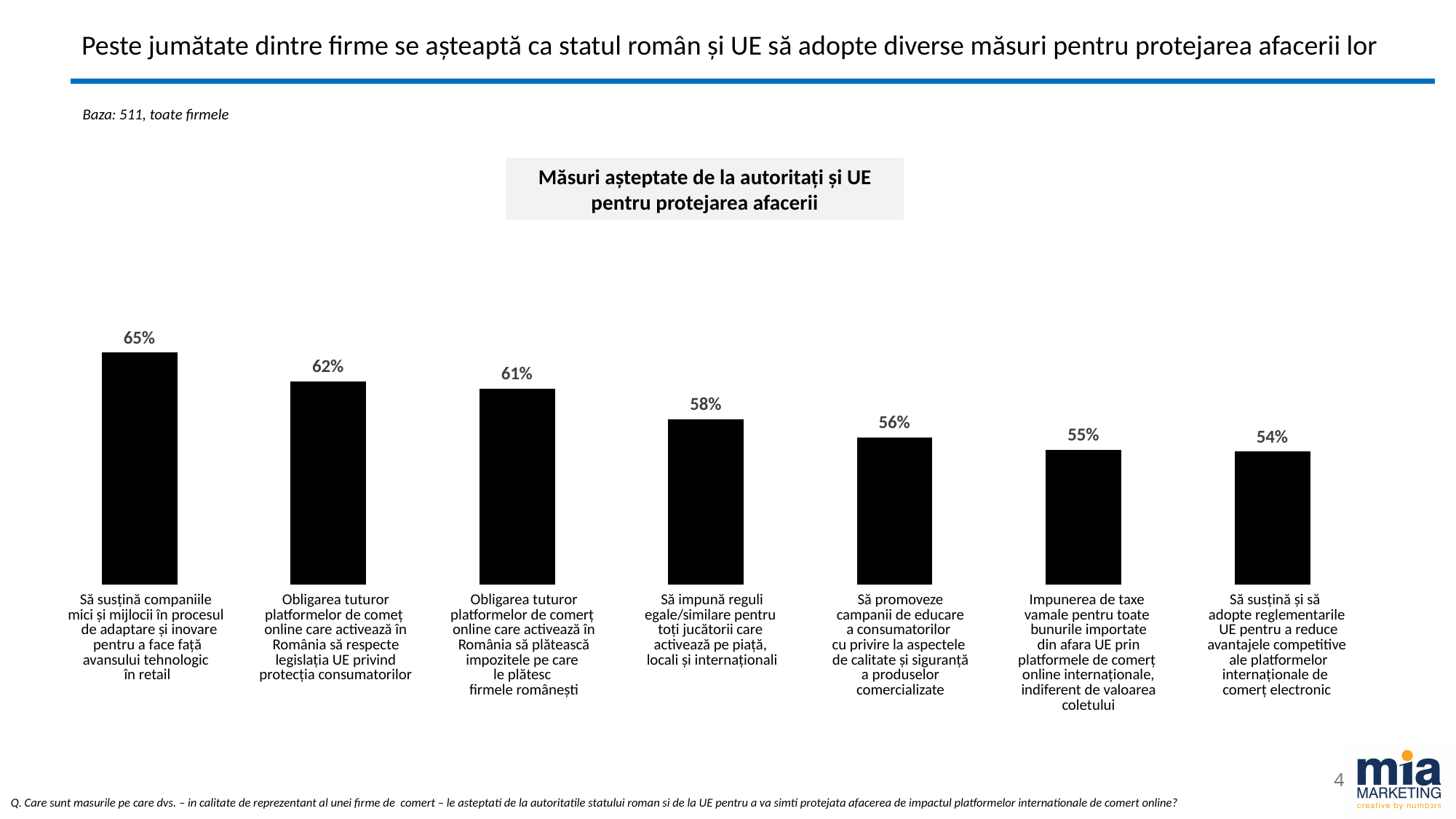
What is the value for "Impunerea de taxe vamale pentru toate bunurile importate din afara UE..."? 55% How many measures (categories) are shown in the chart? 7 Which measure has the highest percentage? Să susțină companiile mici și mijlocii în procesul de adaptare și inovare pentru a face față avansului tehnologic în retail What percentage of firms expect the state to support small and medium companies in adapting and innovating to face technological advances in retail ("Să susțină companiile mici și mijlocii...")? 65% What is the difference between "Obligarea tuturor platformelor de comeț online... să respecte legislația UE" and "Să impună reguli egale/similare pentru toți jucătorii"? 4 percentage points What is the difference between the highest value (65%) and the lowest value (54%)? 11 percentage points Do the values rise or fall from left to right across the chart? Fall What type of chart is shown on the slide? Bar chart Which is larger: the value for "Obligarea tuturor platformelor de comerț online... să plătească impozitele" or the value for "Să promoveze campanii de educare a consumatorilor"? Obligarea tuturor platformelor de comerț online... să plătească impozitele (61%) What is the title shown above the chart? Măsuri așteptate de la autoritați și UE pentru protejarea afacerii What is the value for "Să promoveze campanii de educare a consumatorilor..."? 56% Which measure has the lowest percentage? Să susțină și să adopte reglementarile UE pentru a reduce avantajele competitive ale platformelor internaționale de comerț electronic